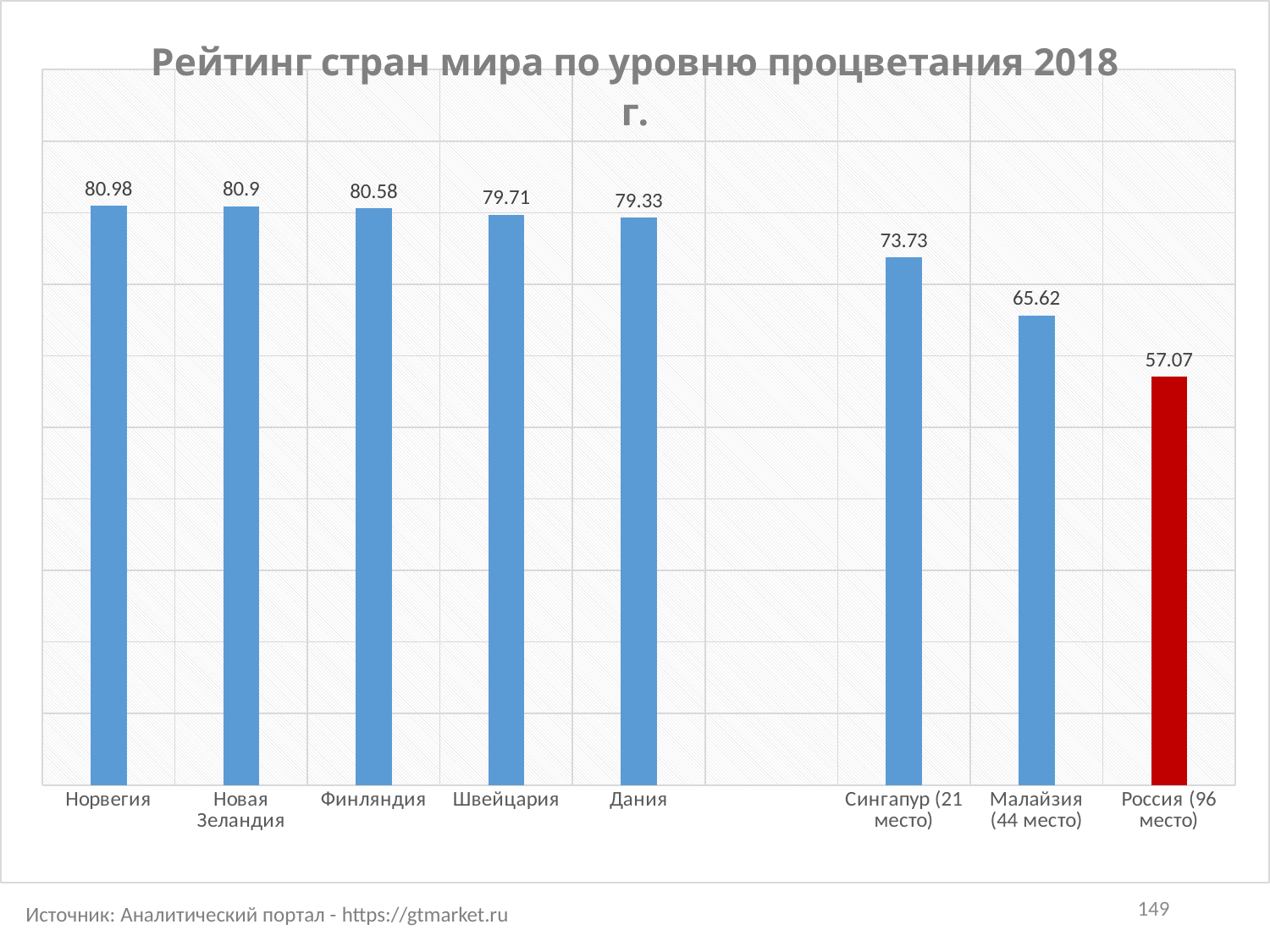
What type of chart is shown on the slide? Bar chart What is the value for Сингапур (21 место)? 73.73 How many bars are plotted on the chart? 8 What is the difference between the values for Норвегия and Россия (96 место)? 23.91 What is the value for Россия (96 место)? 57.07 Which is larger, the value for Швейцария or the value for Малайзия (44 место)? Швейцария Which bar is coloured red rather than blue? Россия (96 место) Which country has the lowest value? Россия (96 место) What is the value for Норвегия? 80.98 Which country has the highest value? Норвегия What is the difference between the values for Сингапур (21 место) and Малайзия (44 место)? 8.11 What is the value for Дания? 79.33